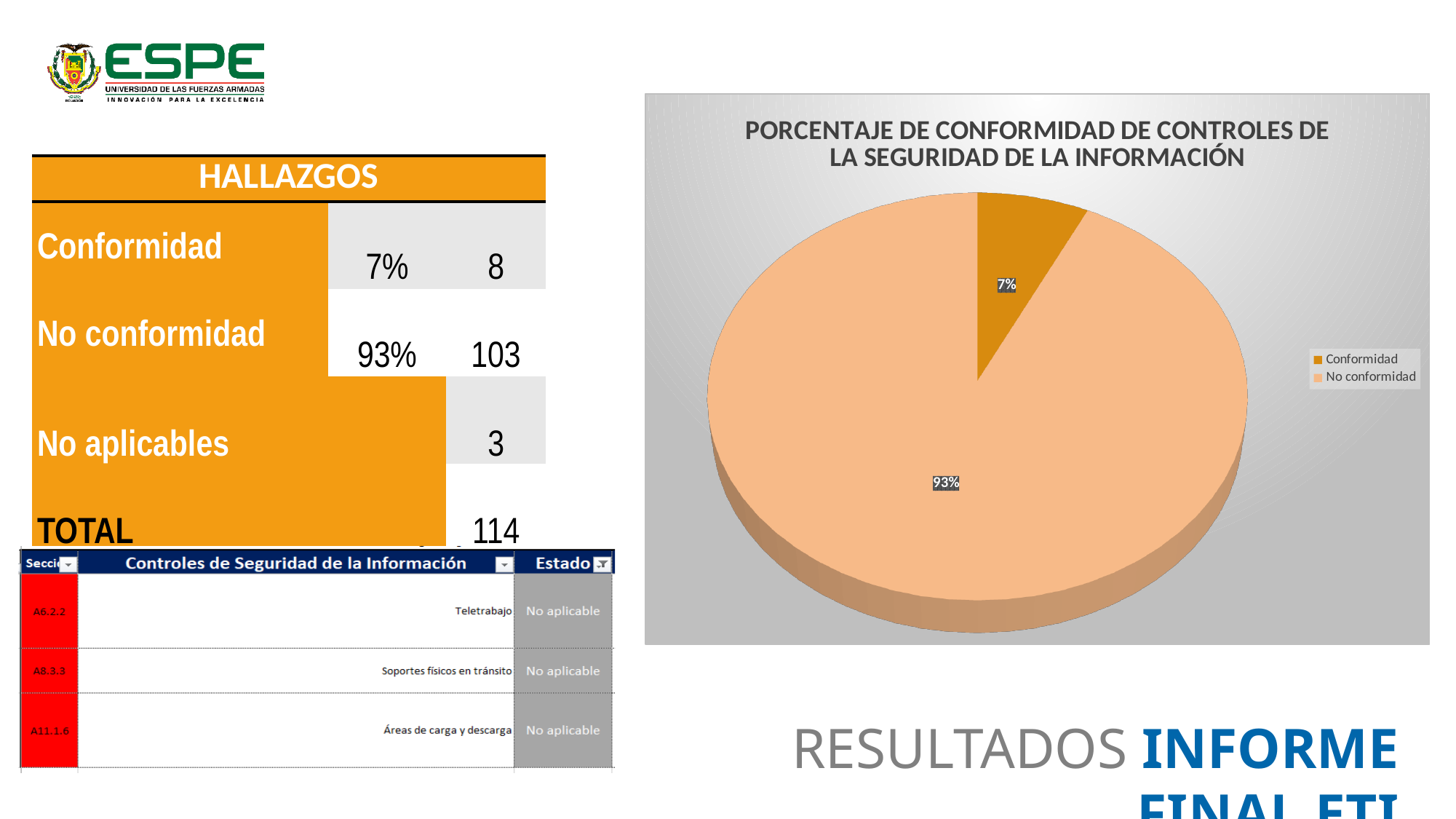
What kind of chart is shown on the slide? pie chart What share of the pie does No conformidad represent? 93% How many entries does the legend of the pie chart list? 2 Which slice of the pie chart is the largest? No conformidad What is the difference in percentage points between the No conformidad slice and the Conformidad slice? 86 How many slices does the pie chart have? 2 Which slice of the pie chart is the smallest? Conformidad What share of the pie does Conformidad represent? 7% Which legend entry is shown in the darker orange colour? Conformidad What is the title of the pie chart? PORCENTAJE DE CONFORMIDAD DE CONTROLES DE LA SEGURIDAD DE LA INFORMACIÓN Which is larger in the pie chart, Conformidad or No conformidad? No conformidad